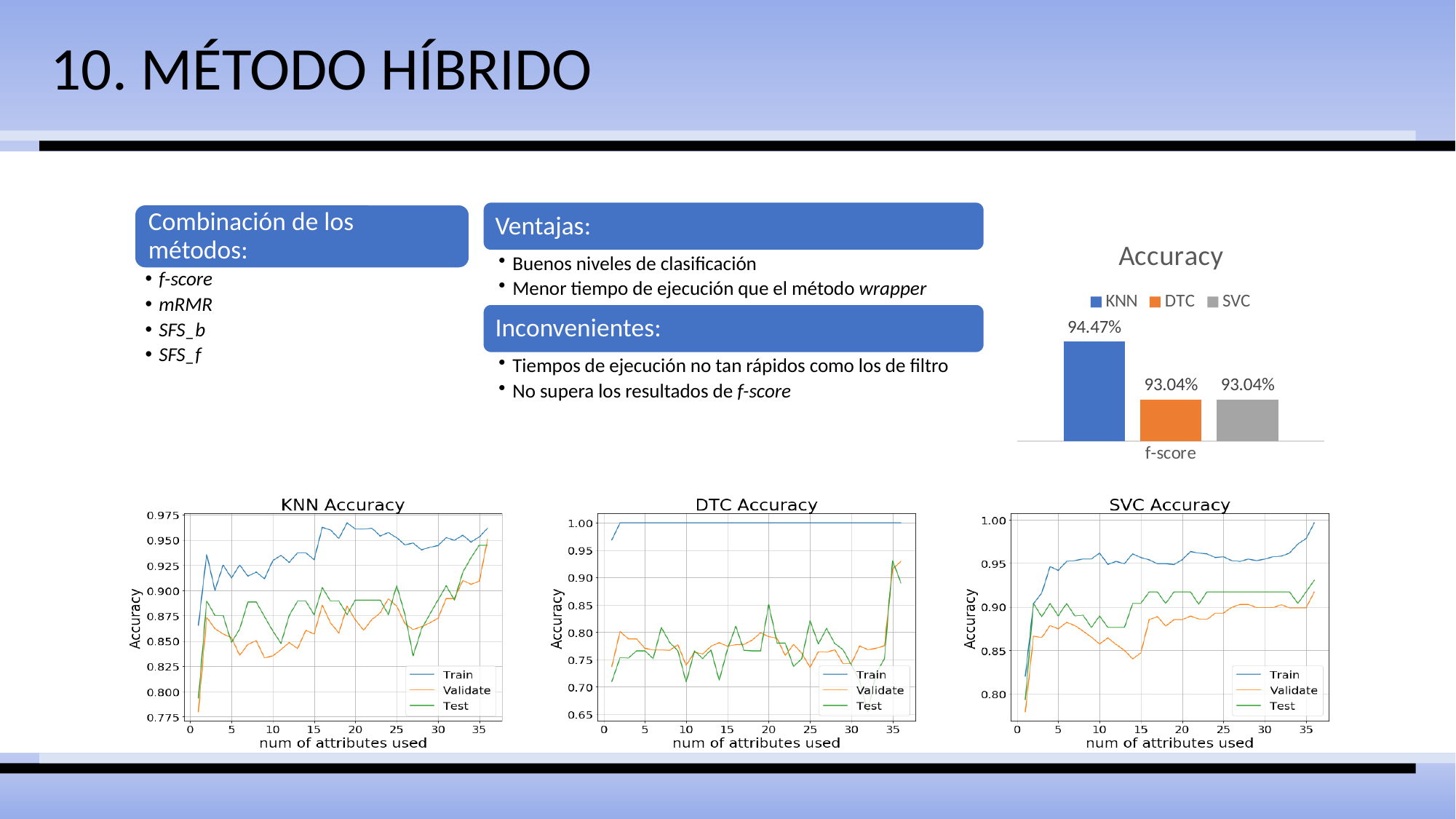
In the "Accuracy" bar chart, what is the value for KNN? 94.47% In the "Accuracy" bar chart, what is the difference between the KNN value and the SVC value? 1.43% In the "KNN Accuracy" chart, what is the label of the x axis? num of attributes used In the "SVC Accuracy" chart, does the Train series generally rise or fall as the number of attributes used increases? rise In the "Accuracy" bar chart, what is the value for DTC? 93.04% What kind of chart is the "Accuracy" chart at the top right of the slide? bar chart In the "Accuracy" bar chart, how many series does the legend list? 3 In the "DTC Accuracy" chart, how many series does the legend list? 3 In the "DTC Accuracy" chart, is the Train value at 20 attributes used greater or less than 0.95? greater What kind of chart is the "KNN Accuracy" chart? line chart In the "Accuracy" bar chart, which series has the highest value? KNN In the "Accuracy" bar chart, what is the category label shown on the x axis? f-score